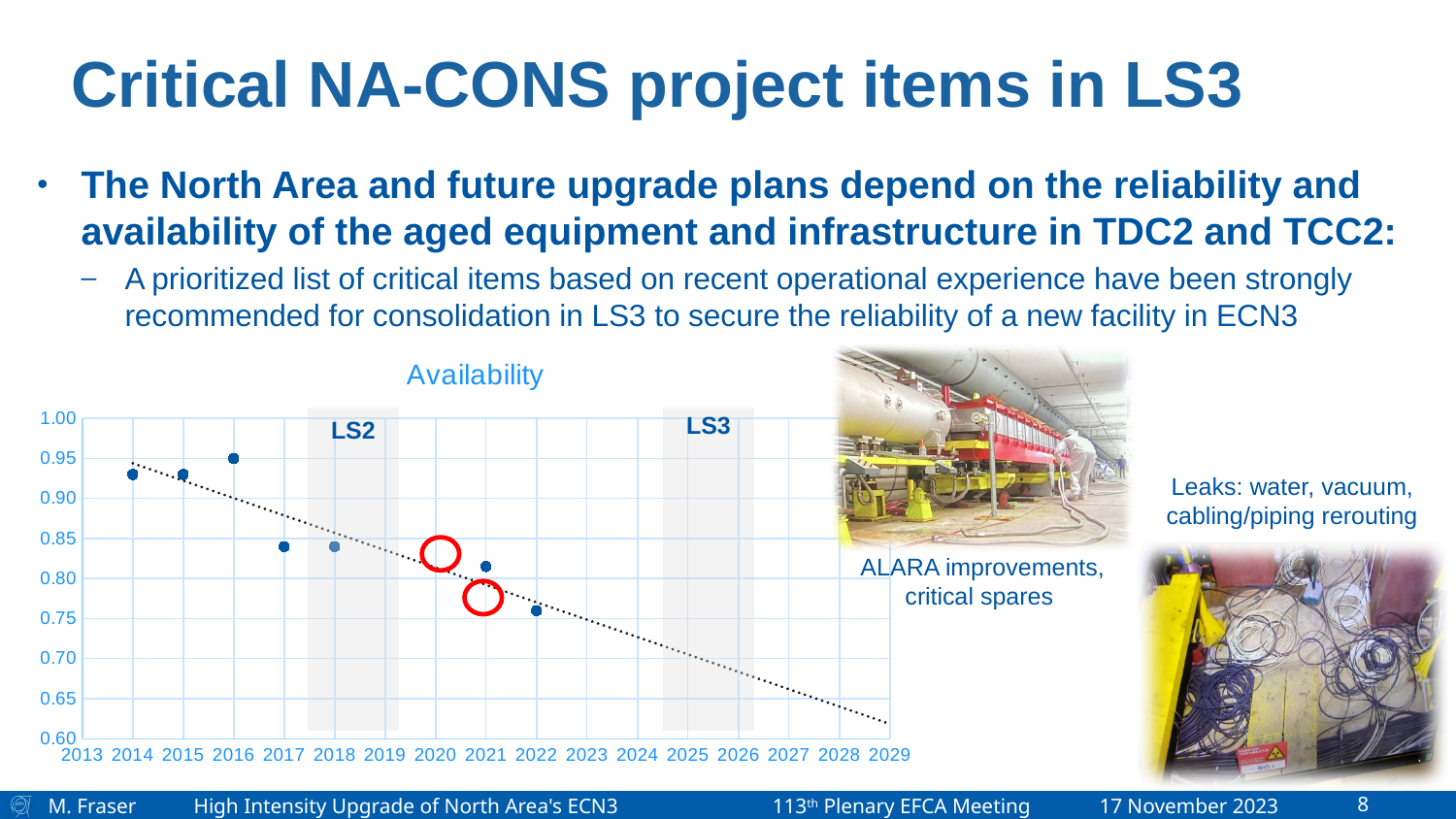
What kind of chart is the Availability chart? scatter chart What is the availability value for 2016? 0.95 Is the availability value for 2014 greater or less than 0.90? greater What is the first year shown on the x axis of the chart? 2013 What are the two shaded periods labelled on the chart? LS2 and LS3 Which year has the larger availability value, 2014 or 2022? 2014 Do the availability values rise or fall over the years shown? fall Which year has the highest availability value? 2016 What is the title of the chart on the slide? Availability Which year has the lowest plotted availability value? 2022 Is the availability value for 2022 greater or less than 0.80? less Is the availability value for 2017 greater or less than 0.90? less